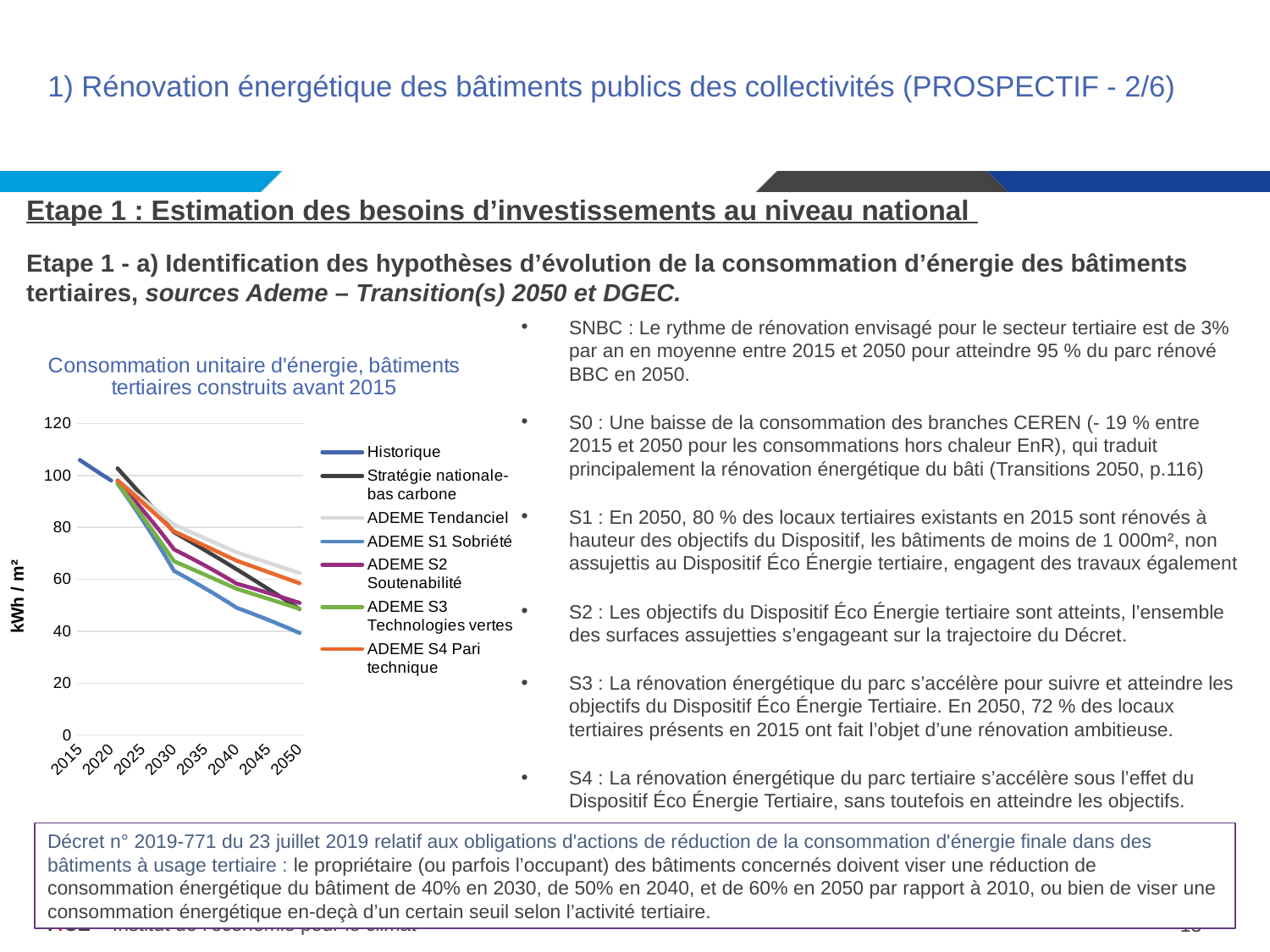
Which series has the highest value in 2050? ADEME Tendanciel How many years are marked along the x axis of the chart? 8 What is the title of the chart? Consommation unitaire d'énergie, bâtiments tertiaires construits avant 2015 Do the values in the chart rise or fall from 2015 to 2050? fall Is the value for Historique in 2015 greater or less than 100? greater What kind of chart is shown on the slide? line chart Which series has the lowest value in 2050? ADEME S1 Sobriété Is the value for ADEME Tendanciel in 2050 greater or less than 40? greater What is the label of the y axis of the chart? kWh / m² How many series does the chart legend list? 7 In 2050, which is larger: ADEME S1 Sobriété or ADEME Tendanciel? ADEME Tendanciel Is the value for ADEME S1 Sobriété in 2050 greater or less than 60? less